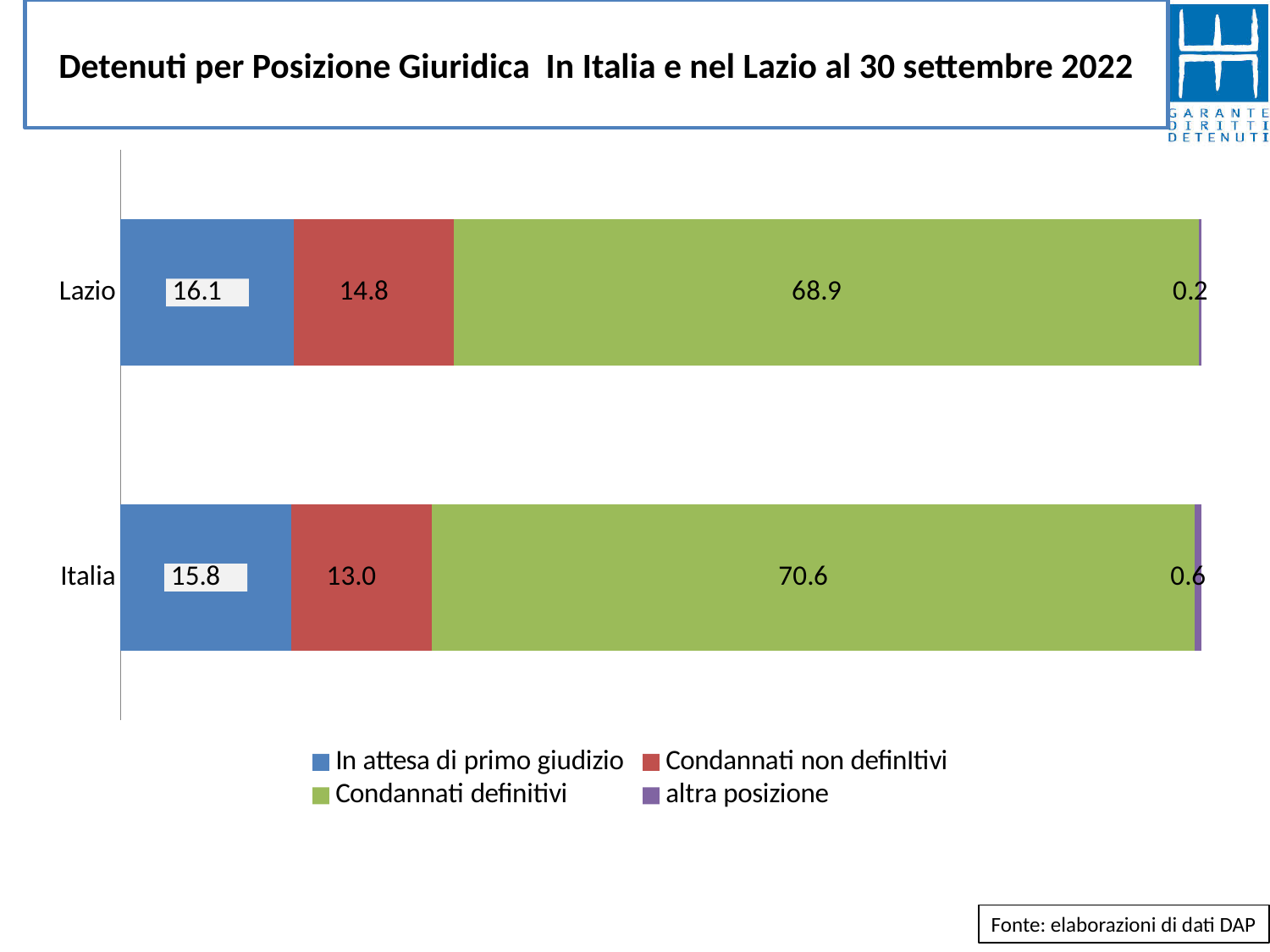
What is the value for "Condannati non definitivi" for Lazio? 14.8 What is the difference between the "Condannati non definitivi" values for Lazio and Italia? 1.8 How many series does the legend list? 4 Which is larger, the "Condannati definitivi" value for Lazio or for Italia? Italia What is the value for "Condannati definitivi" for Lazio? 68.9 What is the value for "altra posizione" for Italia? 0.6 What is the total of the stacked bar for Lazio? 100.0 Which series has the smallest value for Lazio? altra posizione How many categories are shown on the chart? 2 Which series has the largest value for Italia? Condannati definitivi What kind of chart is shown on the slide? Stacked bar chart What is the value for "In attesa di primo giudizio" for Italia? 15.8